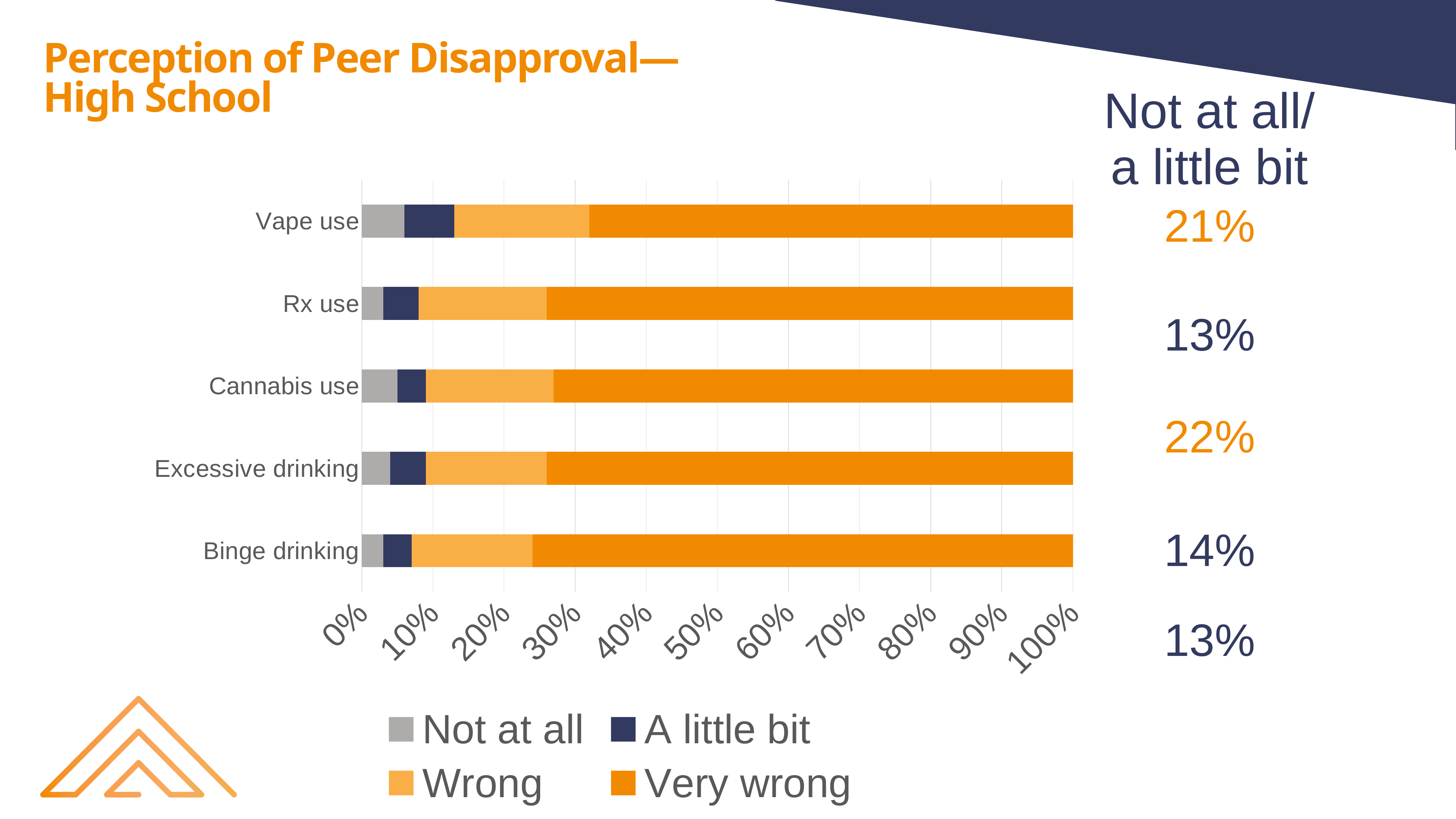
What is the combined 'Not at all/a little bit' percentage shown for Cannabis use? 22% Which category has the smallest 'Very wrong' segment? Vape use What is the title of the slide? Perception of Peer Disapproval—High School Is the 'Very wrong' value for Vape use greater or less than 60%? greater Which has a larger 'Not at all/a little bit' percentage, Vape use or Excessive drinking? Vape use Which category has the highest combined 'Not at all/a little bit' percentage? Cannabis use What is the combined 'Not at all/a little bit' percentage shown for Excessive drinking? 14% What is the combined 'Not at all/a little bit' percentage shown for Vape use? 21% How many substance-use categories are plotted on the chart? 5 What is the difference between the 'Not at all/a little bit' percentages for Cannabis use and Vape use? 1% How many series does the chart legend list? 4 What kind of chart is shown on the slide? Stacked bar chart